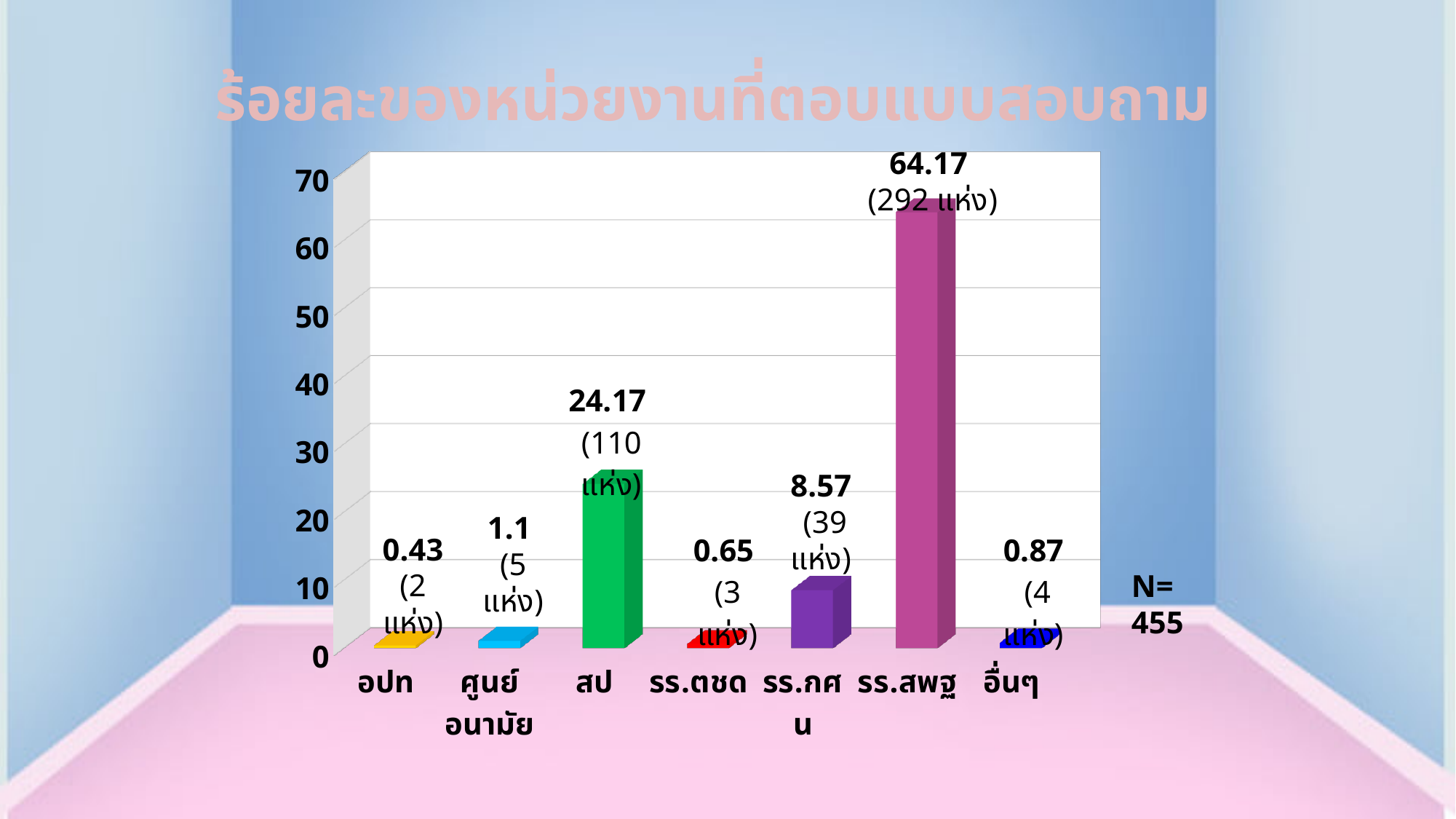
Which is larger, the value for รร.กศน or the value for อื่นๆ? รร.กศน What is the difference between the values for รร.สพฐ and สป? 40 What is the value for รร.กศน? 8.57 Is the value for รร.สพฐ greater or less than 60? greater How many categories are shown on the x axis? 7 How many units (แห่ง) are shown in the label for รร.สพฐ? 292 แห่ง Which category has the highest value? รร.สพฐ What is the value for สป? 24.17 What is the value for ศูนย์อนามัย? 1.1 What is the N value shown next to the chart? N= 455 What kind of chart is shown on the slide? bar chart Which category has the lowest value? อปท